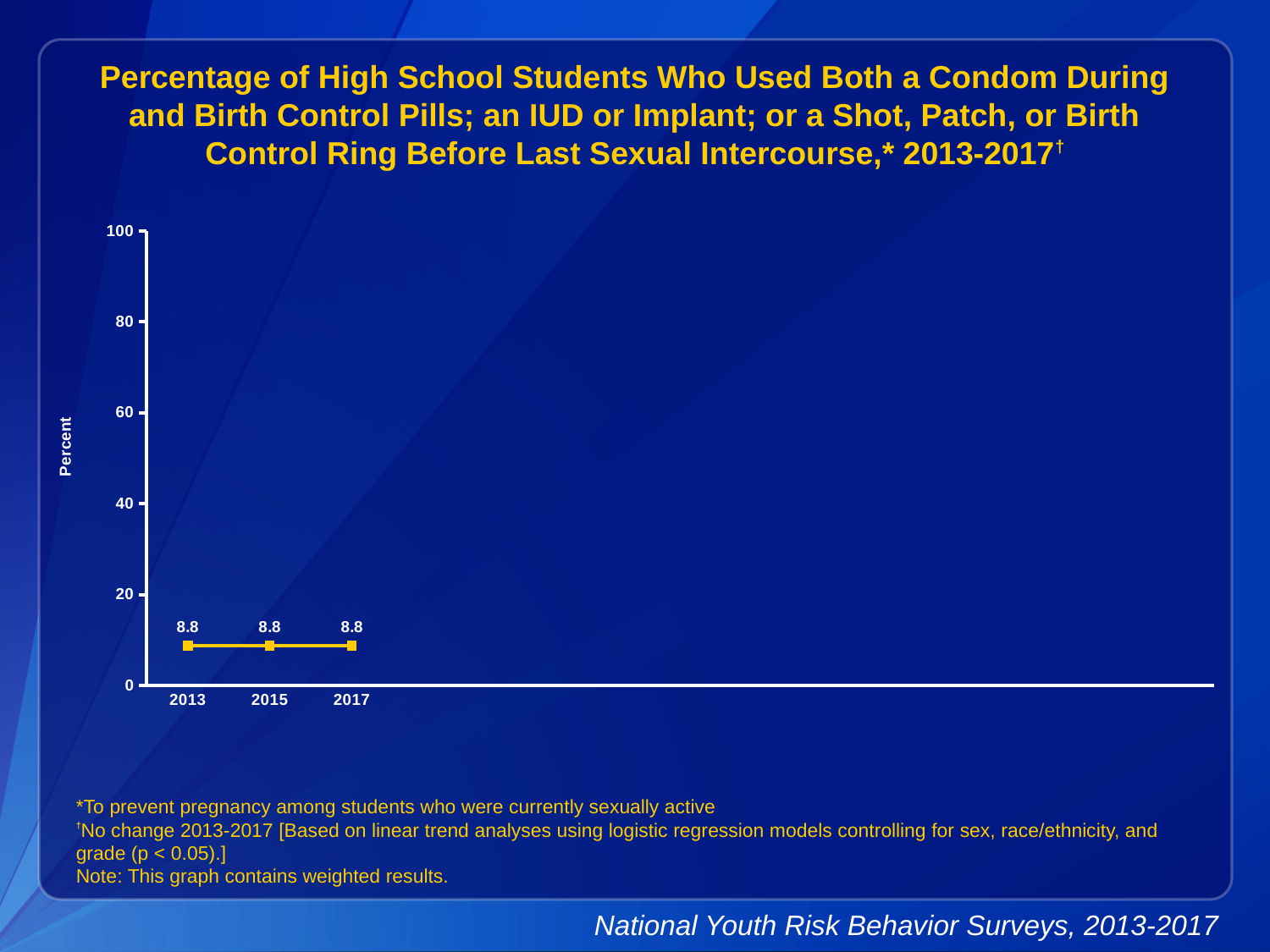
What is the maximum value shown on the y axis? 100 What is the label on the y axis? Percent What is the value for 2013? 8.8 How many years are plotted on the chart? 3 Do the values rise, fall, or stay the same from 2013 to 2017? stay the same What is the value for 2015? 8.8 What is the value for 2017? 8.8 Is the value for 2015 greater or less than 20? less What kind of chart is shown on the slide? line chart What is the difference between the values for 2013 and 2017? 0